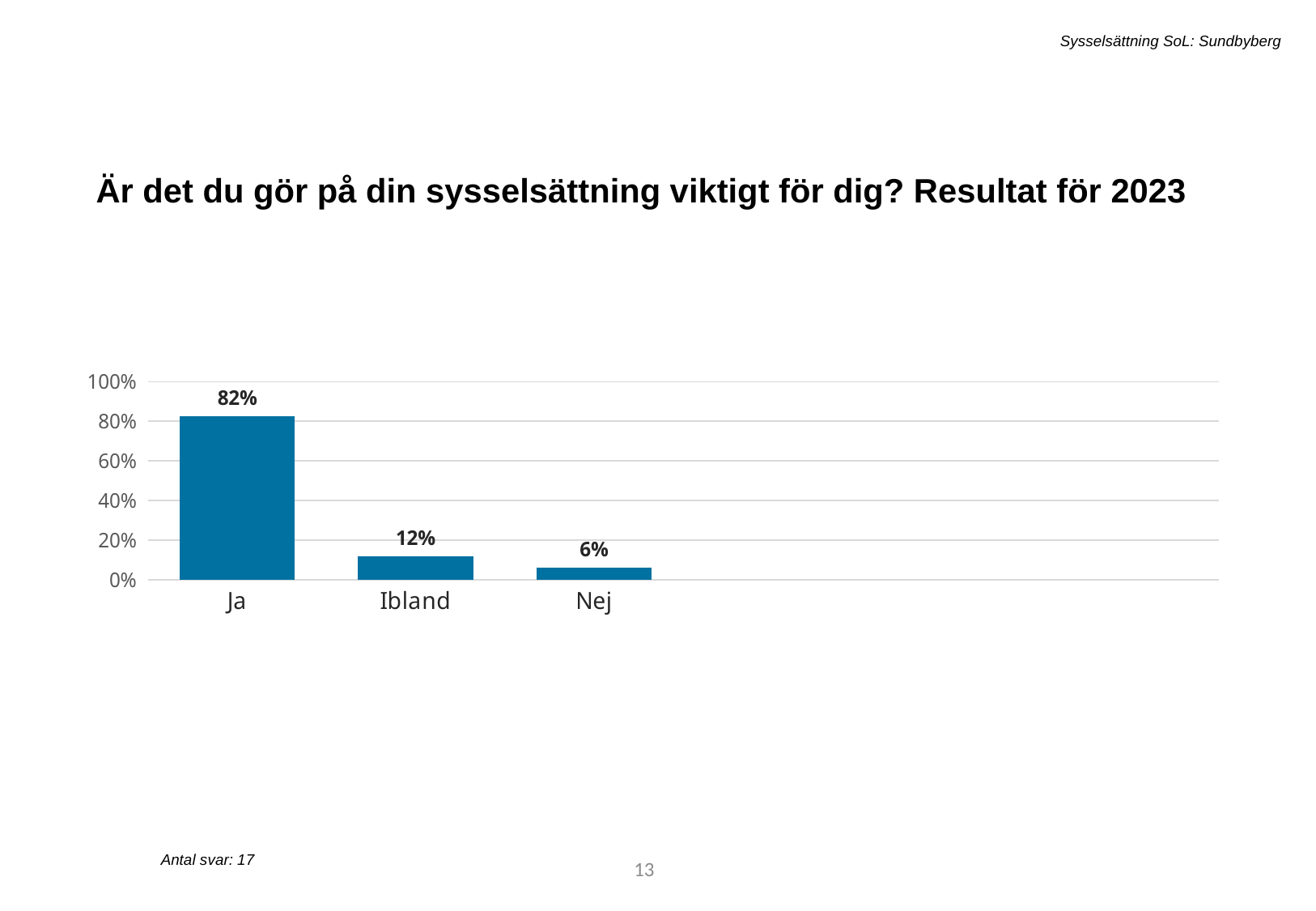
Which category has the highest value? Ja How many categories are shown on the x axis? 3 What is the value for Ibland? 12% What is the difference between the values for Ibland and Nej? 6% Which category has the lowest value? Nej What is the value for Ja? 82% What is the title of the chart? Är det du gör på din sysselsättning viktigt för dig? Resultat för 2023 What is the difference between the values for Ja and Ibland? 70% What is the value for Nej? 6% What kind of chart is shown on the slide? bar chart Is the value for Ja greater or less than 60%? greater Which is larger, the value for Ibland or the value for Nej? Ibland